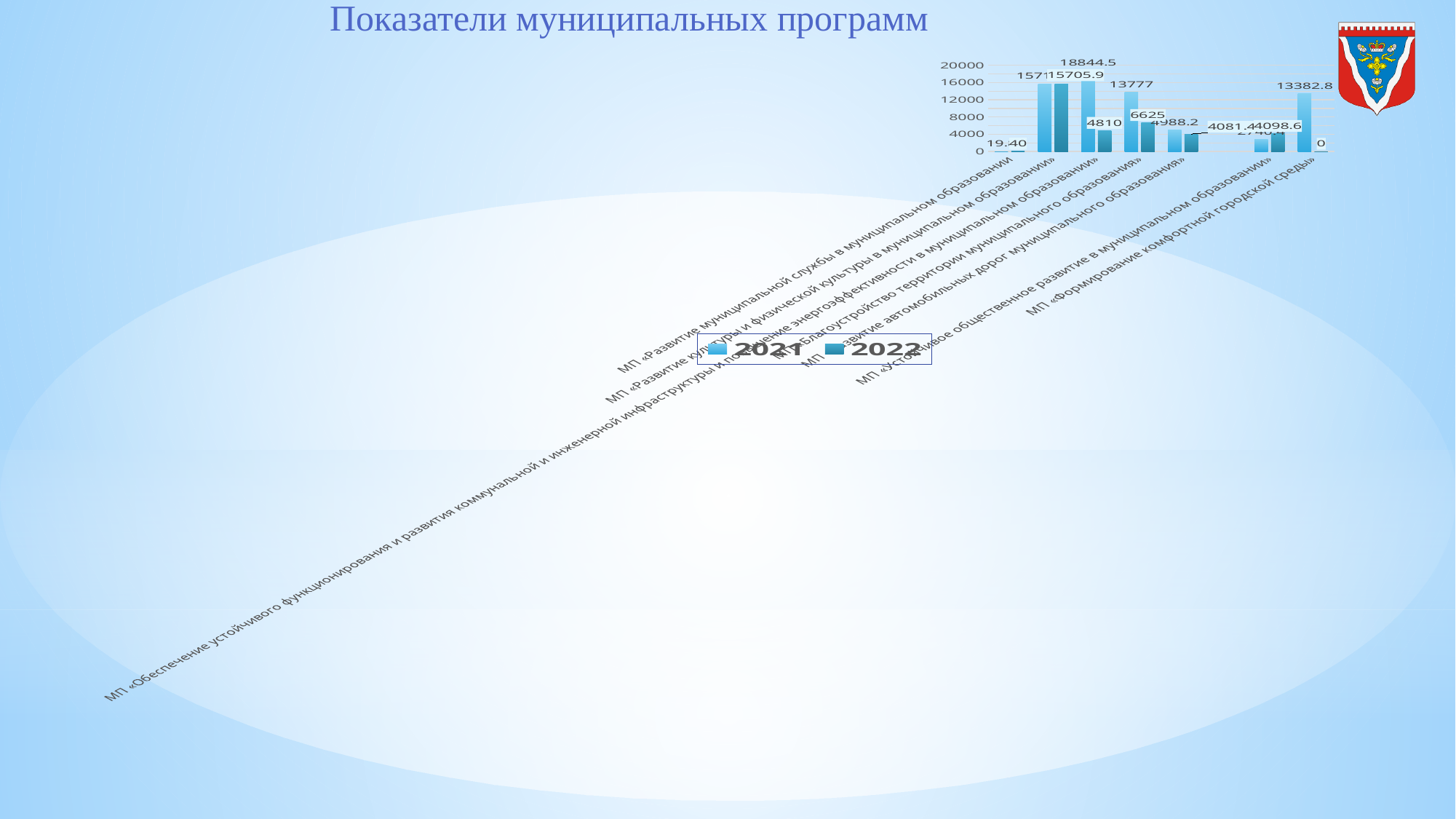
Which category has the tallest bar on the chart? МП «Обеспечение устойчивого функционирования и развития коммунальной и инженерной инфраструктуры и повышение энергоэффективности в муниципальном образовании» For МП «Формирование комфортной городской среды», which year has the larger value, 2021 or 2022? 2021 What kind of chart is shown on the slide? bar chart What is the title of the slide containing the chart? Показатели муниципальных программ What is the 2022 value for МП «Формирование комфортной городской среды»? 0 How many series does the chart legend list? 2 What is the 2022 value for МП «Развитие культуры и физической культуры в муниципальном образовании»? 15705.9 What is the highest value labelled on the chart? 18844.5 What are the two series named in the chart legend? 2021 and 2022 What is the 2021 value for МП «Формирование комфортной городской среды»? 13382.8